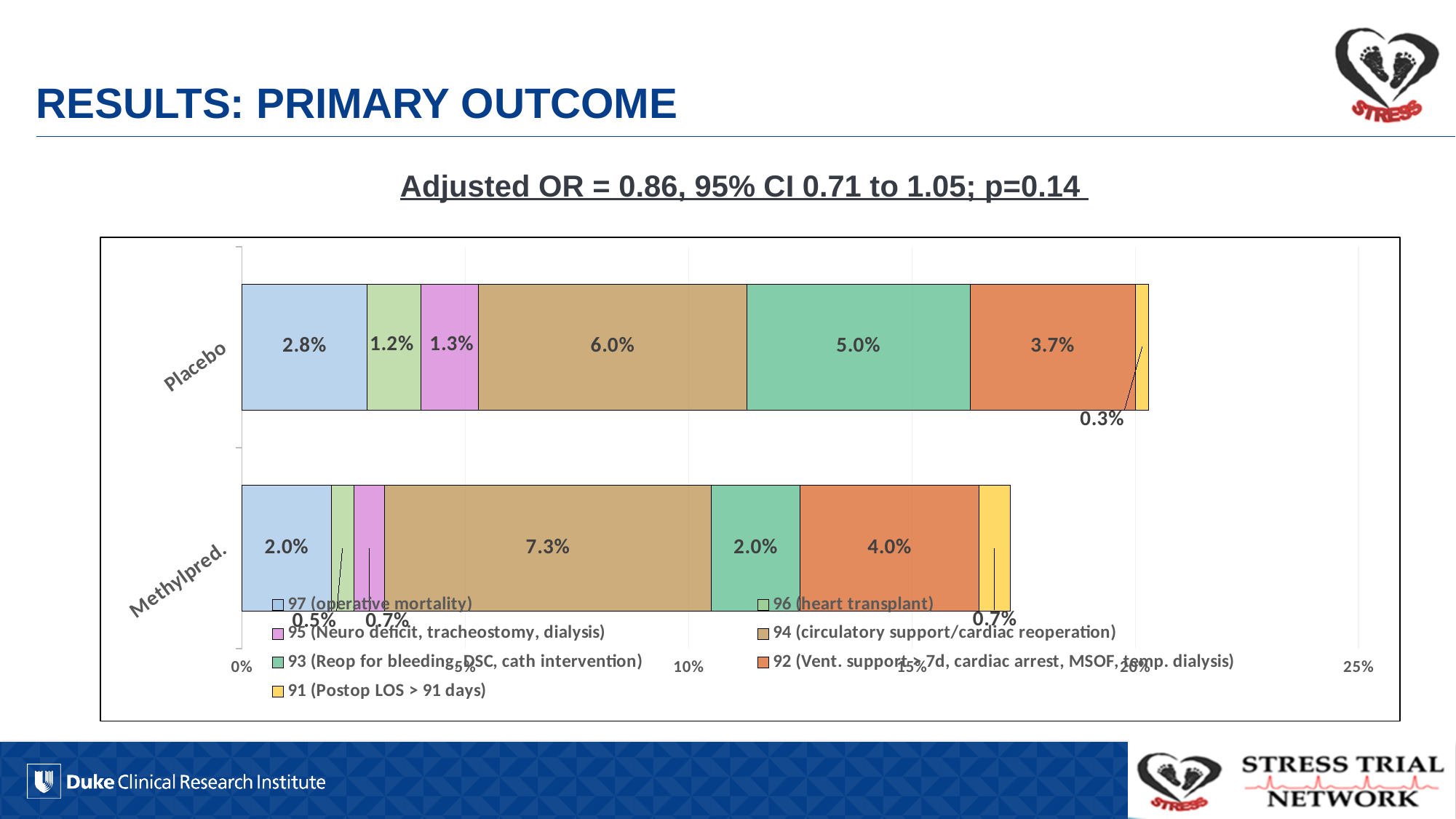
What is the total of the Placebo stacked bar? 20.3% How many series does the chart legend list? 7 How many treatment groups (bars) are plotted in the chart? 2 What is the value of the 94 (circulatory support/cardiac reoperation) segment for Methylpred.? 7.3% Which segment is the largest in the Placebo bar? 94 (circulatory support/cardiac reoperation) What kind of chart is shown on the slide? Stacked bar chart What is the difference between the 92 (Vent. support > 7d, cardiac arrest, MSOF, temp. dialysis) values for Methylpred. and Placebo? 0.3% Which group has the larger 93 (Reop for bleeding, DSC, cath intervention) value, Placebo or Methylpred.? Placebo Which segment is the smallest in the Placebo bar? 91 (Postop LOS > 91 days) What is the value of the 97 (operative mortality) segment for Placebo? 2.8% What is the value of the 93 (Reop for bleeding, DSC, cath intervention) segment for Placebo? 5.0% What is the value of the 91 (Postop LOS > 91 days) segment for Methylpred.? 0.7%